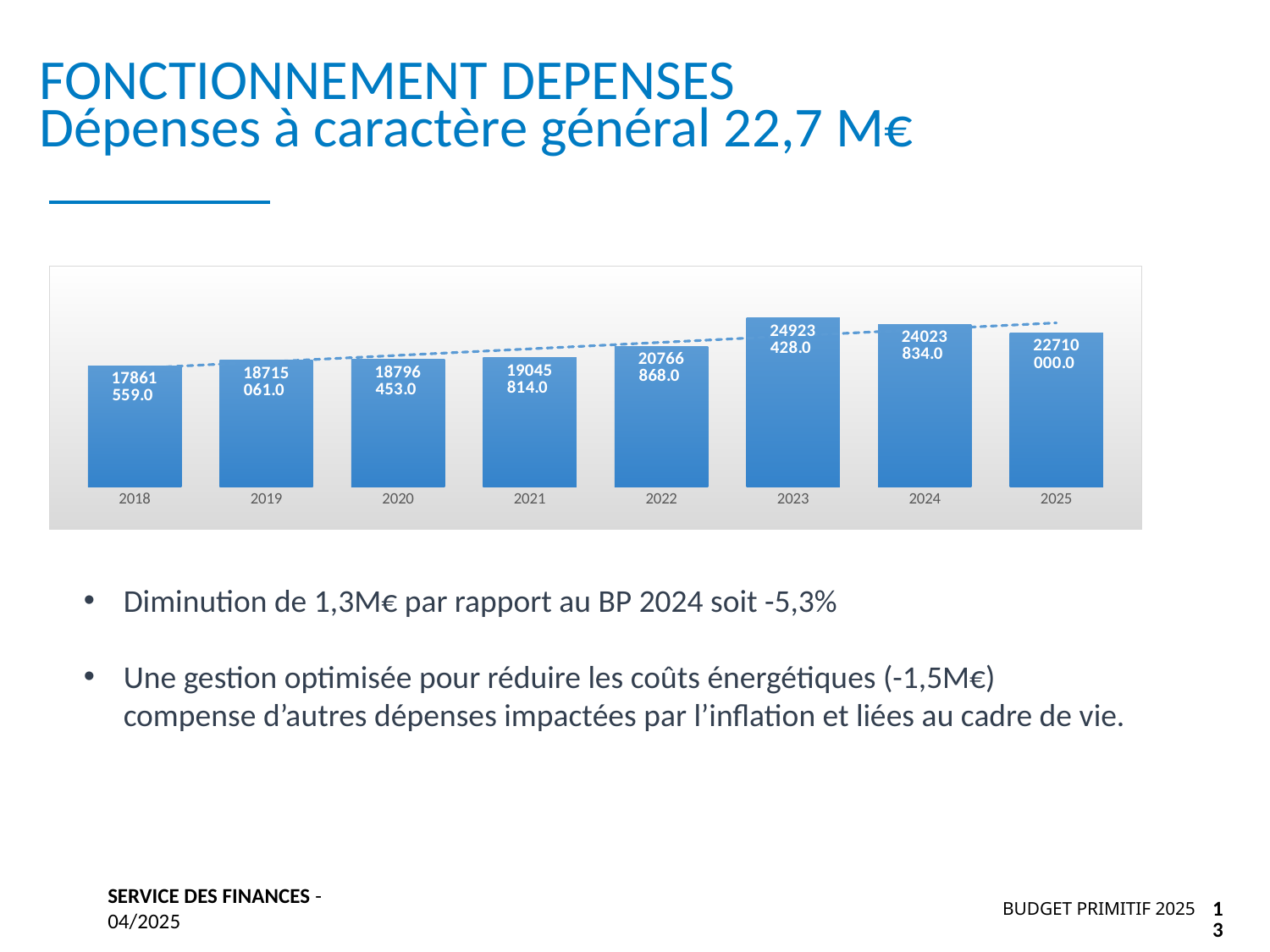
What is the value for 2018? 17861 559.0 What is the value for 2025? 22710 000.0 Which year has the highest value? 2023 How many years are shown on the x axis? 8 Which year has the lowest value? 2018 What kind of chart is shown on the slide? Bar chart What is the difference between the values for 2024 and 2025? 1313 834.0 What is the value for 2021? 19045 814.0 What is the difference between the values for 2023 and 2024? 899 594.0 Which is larger, the value for 2024 or the value for 2025? 2024 Do the values rise or fall from 2018 to 2023? Rise What is the value for 2023? 24923 428.0